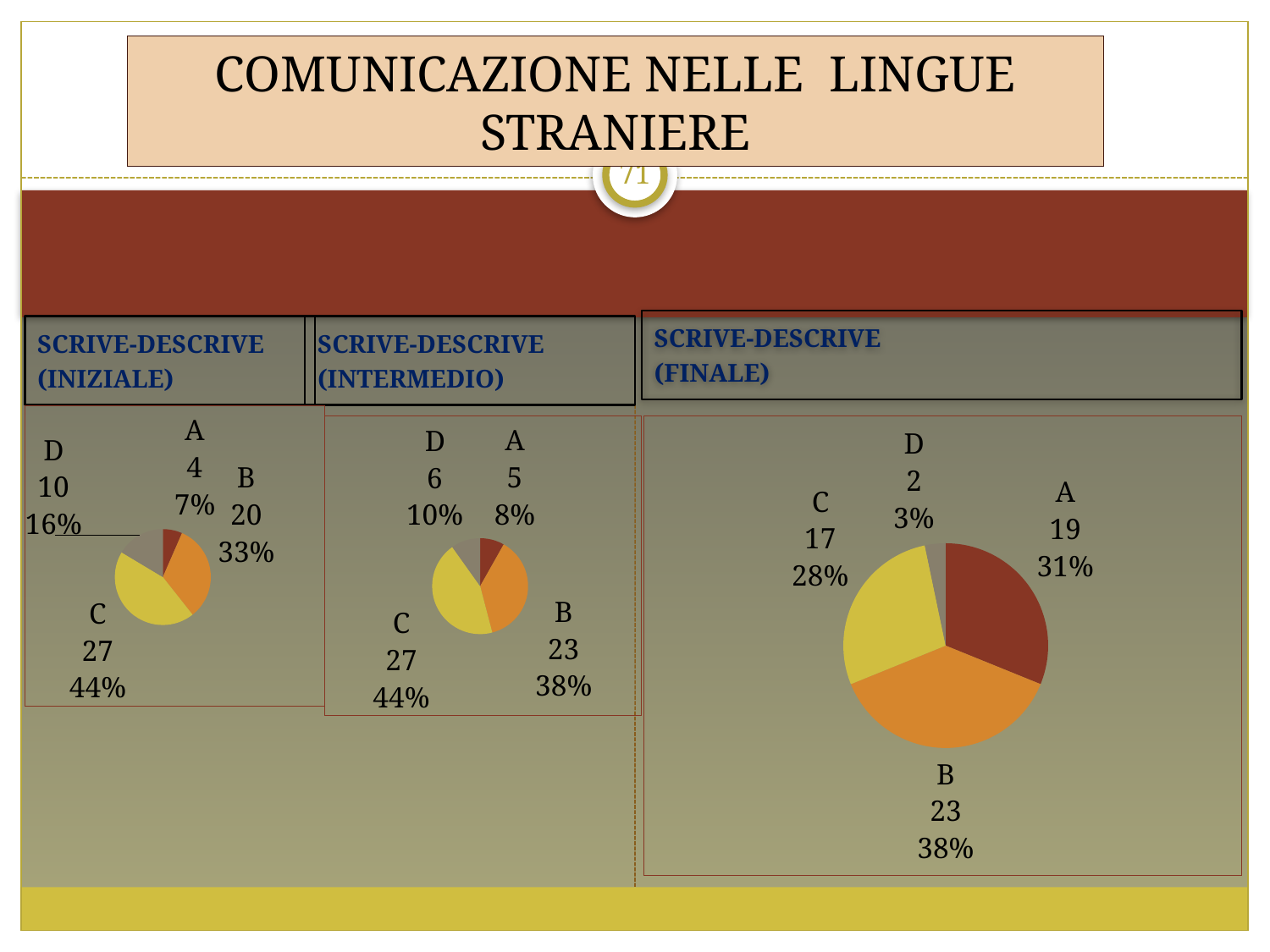
In the SCRIVE-DESCRIVE (INTERMEDIO) chart, what value is shown for category B? 23 In the SCRIVE-DESCRIVE (FINALE) chart, which category has the smallest value? D In the SCRIVE-DESCRIVE (FINALE) chart, what value is shown for category A? 19 In the SCRIVE-DESCRIVE (INTERMEDIO) chart, what is the difference between the values for C and D? 21 In the SCRIVE-DESCRIVE (INIZIALE) chart, which category has the smallest value? A In the SCRIVE-DESCRIVE (INTERMEDIO) chart, which category has the largest value? C How many categories does the SCRIVE-DESCRIVE (FINALE) chart show? 4 What type of chart is used for SCRIVE-DESCRIVE (FINALE)? Pie chart In the SCRIVE-DESCRIVE (FINALE) chart, which is larger, the value for A or the value for C? A In the SCRIVE-DESCRIVE (INIZIALE) chart, what percentage share does category D have? 16% In the SCRIVE-DESCRIVE (INIZIALE) chart, what value is shown for category C? 27 In the SCRIVE-DESCRIVE (FINALE) chart, what percentage share does category B have? 38%